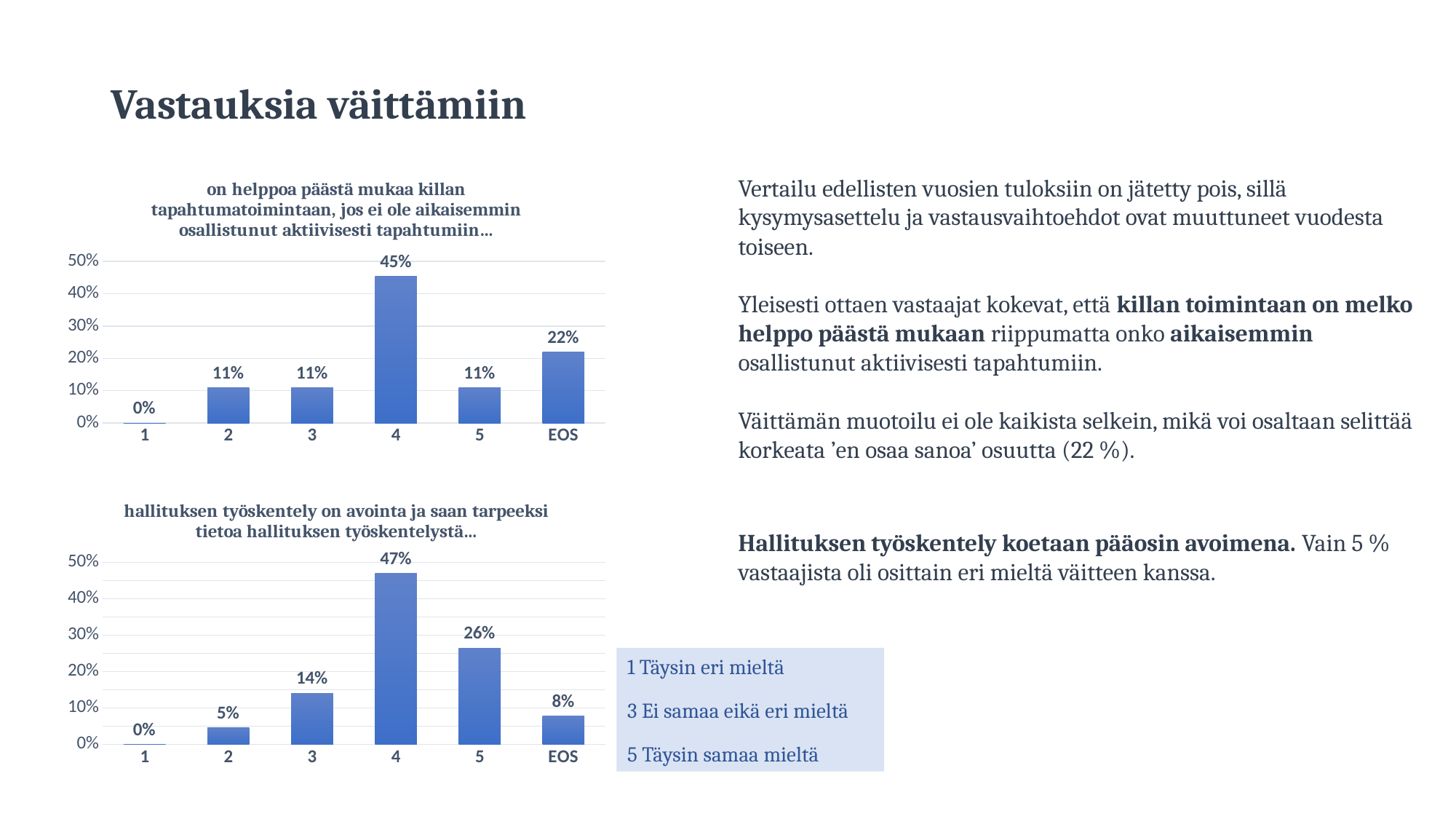
In the bottom chart, which is larger, the value for category 3 or the value for EOS? category 3 In the bottom chart, what is the difference between the values for category 4 and category 5? 21% In the bottom chart, which category has the highest value? 4 How many categories are shown on the x axis of the bottom chart? 6 In the bottom chart, what is the value for category 2? 5% In the top chart, which category has the highest value? 4 In the top chart, what is the value for EOS? 22% In the top chart, what is the difference between the values for category 4 and EOS? 23% In the top chart, which category has the lowest value? 1 What type of chart is the top chart? bar chart In the bottom chart ("hallituksen työskentely on avointa..."), what is the value for category 5? 26% In the top chart ("on helppoa päästä mukaa killan tapahtumatoimintaan..."), what is the value for category 4? 45%